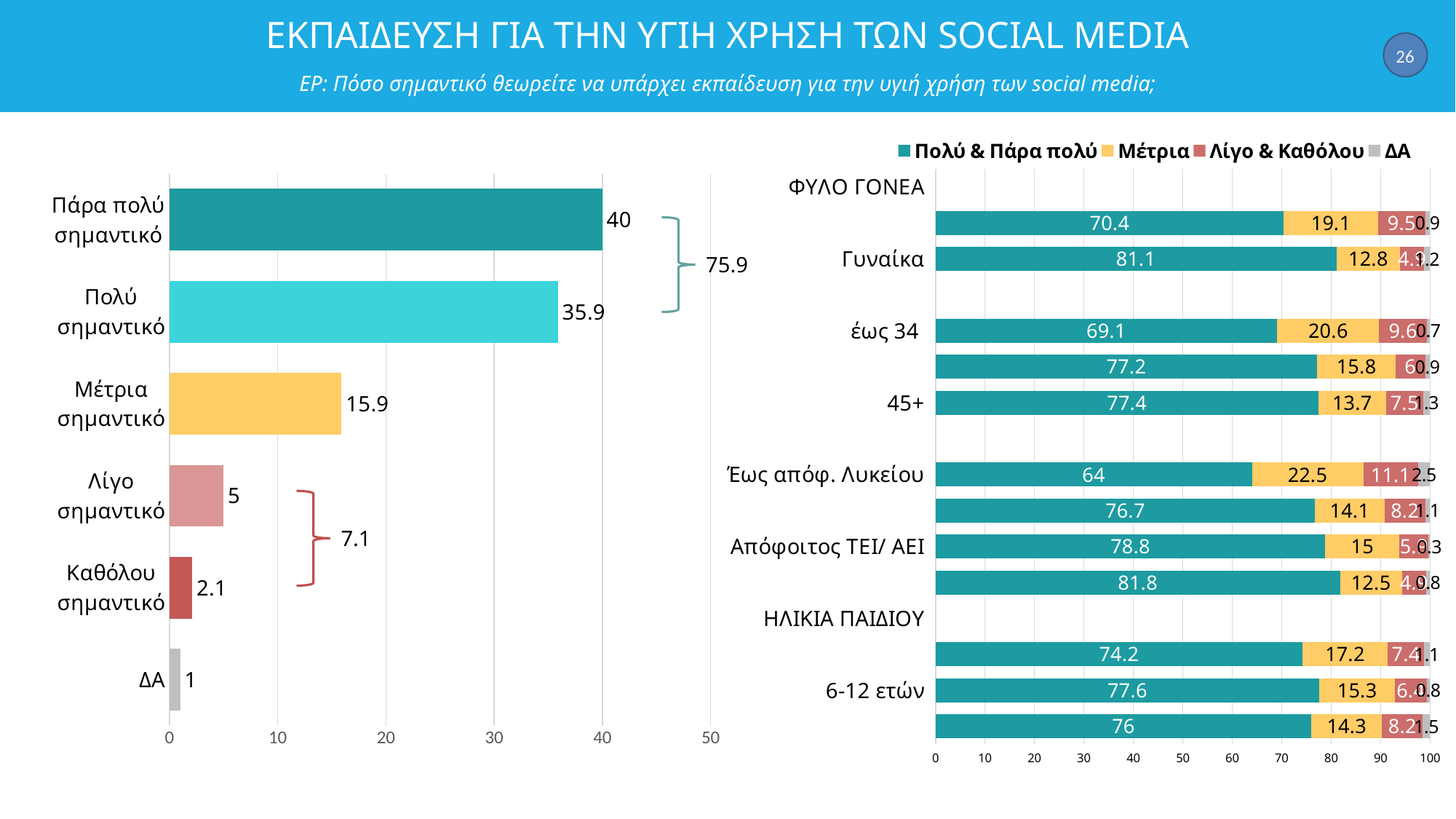
On the left chart, what kind of chart is it? bar chart On the left chart, which category has the highest value? Πάρα πολύ σημαντικό On the right chart, what is the Μέτρια value for Έως απόφ. Λυκείου? 22.5 On the left chart, how many categories are shown? 6 On the right chart, what is the Πολύ & Πάρα πολύ value for Γυναίκα? 81.1 On the right chart, how many series does the legend list? 4 On the left chart, which category has the lowest value? ΔΑ On the left chart, what is the value for Πάρα πολύ σημαντικό? 40 On the right chart, which is larger for Πολύ & Πάρα πολύ: έως 34 or 45+? 45+ On the right chart, is the Πολύ & Πάρα πολύ value for Απόφοιτος ΤΕΙ/ ΑΕΙ greater or less than 70? greater On the left chart, what is the difference between Πάρα πολύ σημαντικό and Πολύ σημαντικό? 4.1 On the left chart, what is the value for Μέτρια σημαντικό? 15.9